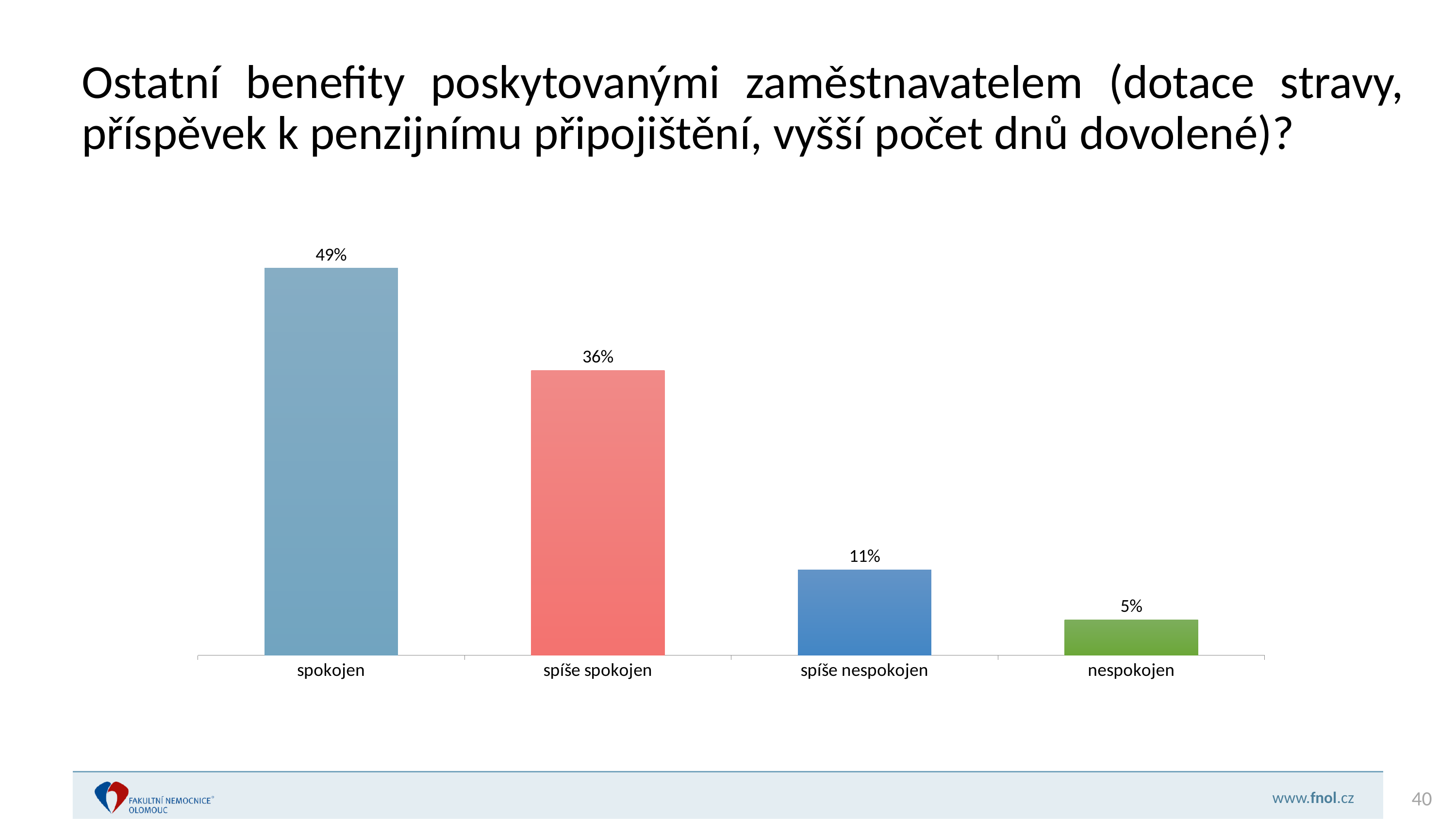
Which category has the lowest value? nespokojen What kind of chart is shown on the slide? bar chart Do the values rise or fall from left to right along the x axis? fall Which is larger, the value for "spíše spokojen" or the value for "spíše nespokojen"? spíše spokojen What is the difference between the values for "spíše nespokojen" and "nespokojen"? 6% How many categories are shown on the chart? 4 Which category has the highest value? spokojen What is the value for "spokojen"? 49% What is the value for "spíše spokojen"? 36% What is the difference between the values for "spokojen" and "spíše spokojen"? 13% What is the value for "nespokojen"? 5% What is the value for "spíše nespokojen"? 11%